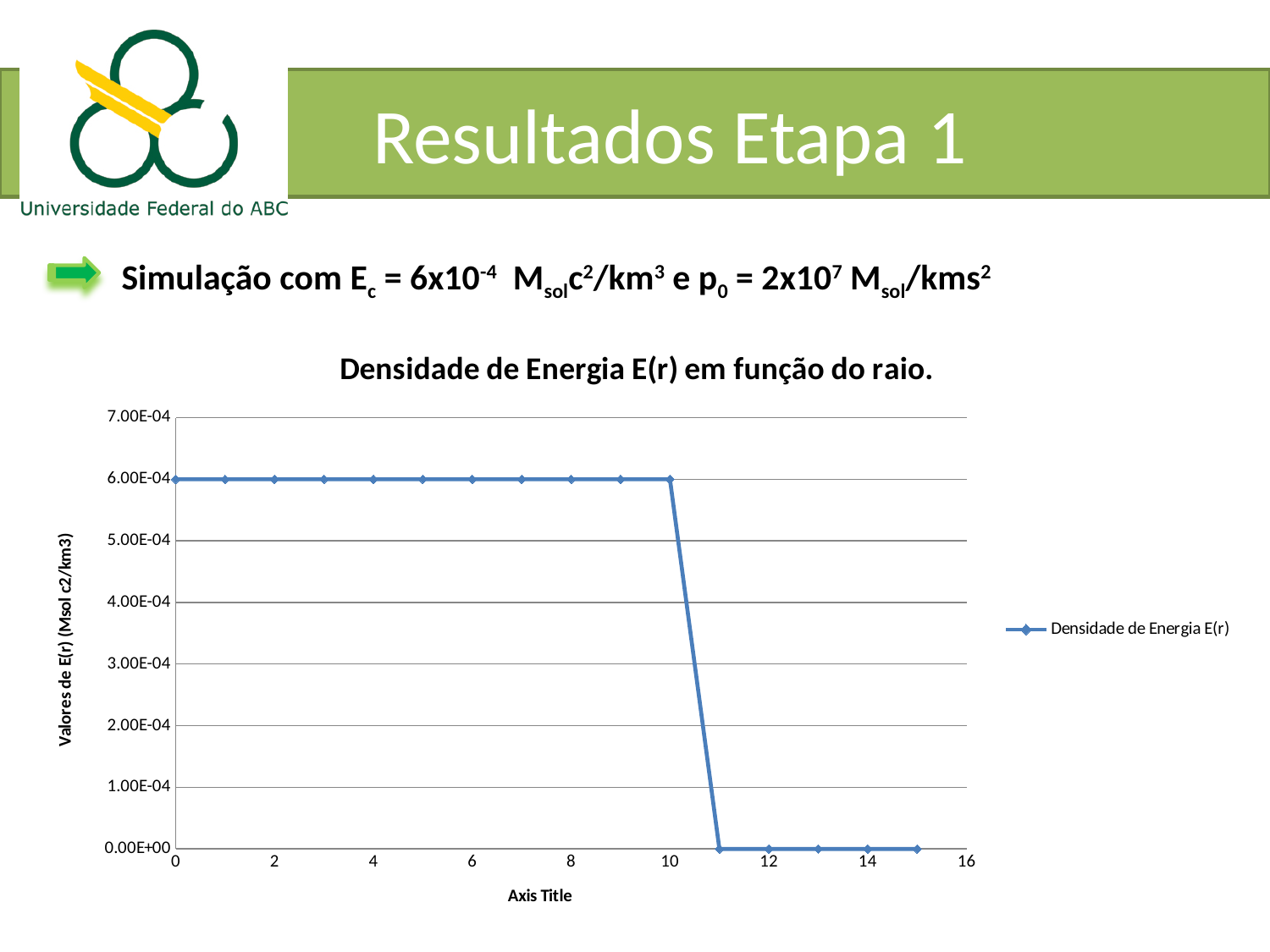
What is the value of Densidade de Energia E(r) at x = 12? 0.00E+00 What is the value of Densidade de Energia E(r) at x = 5? 6.00E-04 How many series does the legend list? 1 What is the value of Densidade de Energia E(r) at x = 10? 6.00E-04 What is the name of the series shown in the legend? Densidade de Energia E(r) Is the value of Densidade de Energia E(r) at x = 3 greater or less than 5.00E-04? greater What is the difference between the value at x = 2 and the value at x = 13? 6.00E-04 Which has the larger value of Densidade de Energia E(r): x = 8 or x = 14? x = 8 What is the title of the chart? Densidade de Energia E(r) em função do raio. How many data points are plotted on the chart? 16 Do the values of Densidade de Energia E(r) rise or fall as x increases from 0 to 15? fall What kind of chart is shown on the slide? line chart